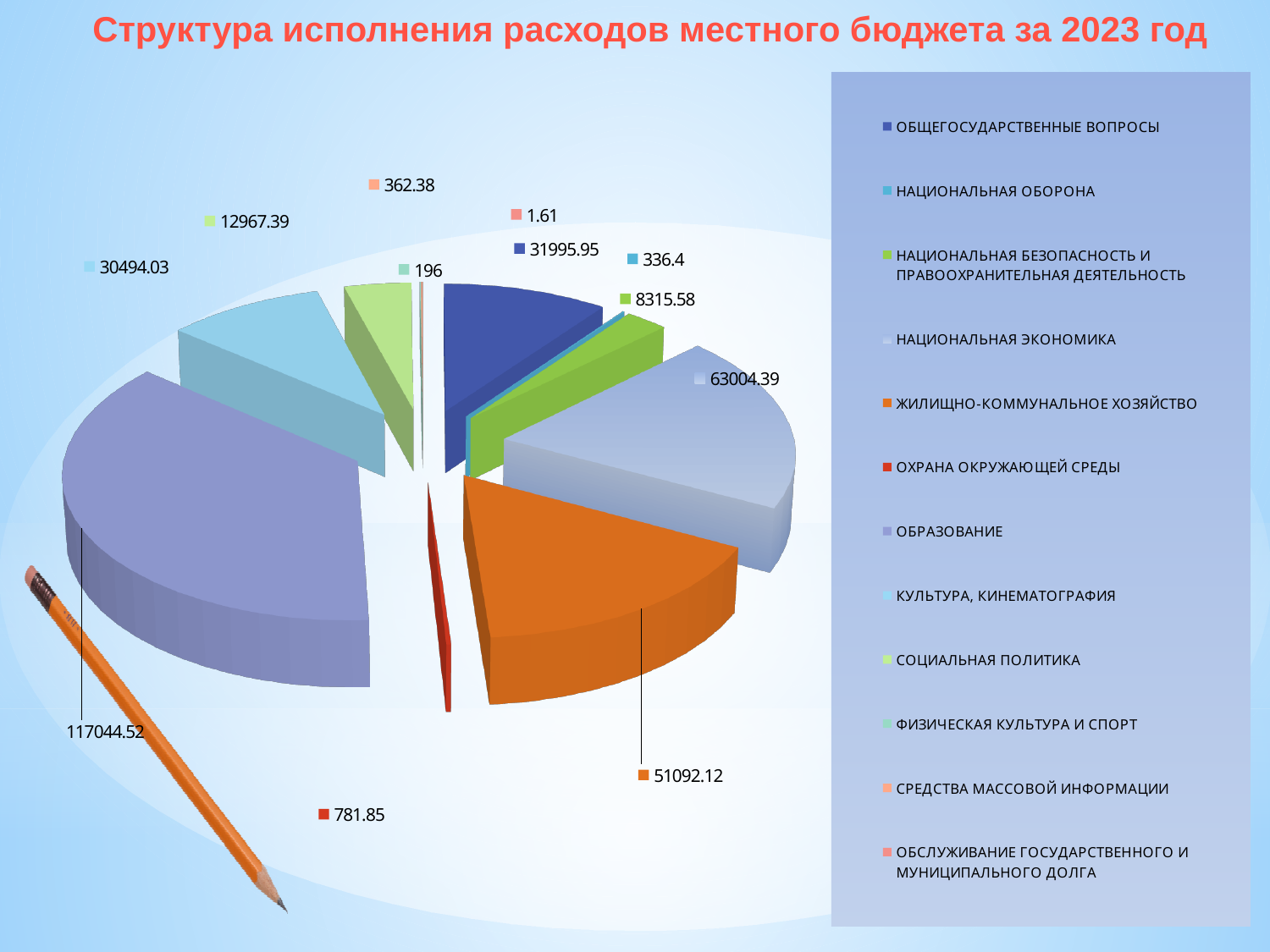
How many categories does the legend list? 12 Which category has the largest value? ОБРАЗОВАНИЕ What is the value for ОБРАЗОВАНИЕ? 117044.52 What is the title of the chart? Структура исполнения расходов местного бюджета за 2023 год What is the value for ОБЩЕГОСУДАРСТВЕННЫЕ ВОПРОСЫ? 31995.95 What is the value for КУЛЬТУРА, КИНЕМАТОГРАФИЯ? 30494.03 Which is larger, the value for НАЦИОНАЛЬНАЯ ЭКОНОМИКА or the value for ЖИЛИЩНО-КОММУНАЛЬНОЕ ХОЗЯЙСТВО? НАЦИОНАЛЬНАЯ ЭКОНОМИКА What is the value for ЖИЛИЩНО-КОММУНАЛЬНОЕ ХОЗЯЙСТВО? 51092.12 What is the value for НАЦИОНАЛЬНАЯ ЭКОНОМИКА? 63004.39 What type of chart is shown on the slide? Pie chart What is the difference between the values for ОБРАЗОВАНИЕ and НАЦИОНАЛЬНАЯ ЭКОНОМИКА? 54040.13 Which category has the smallest value? ОБСЛУЖИВАНИЕ ГОСУДАРСТВЕННОГО И МУНИЦИПАЛЬНОГО ДОЛГА